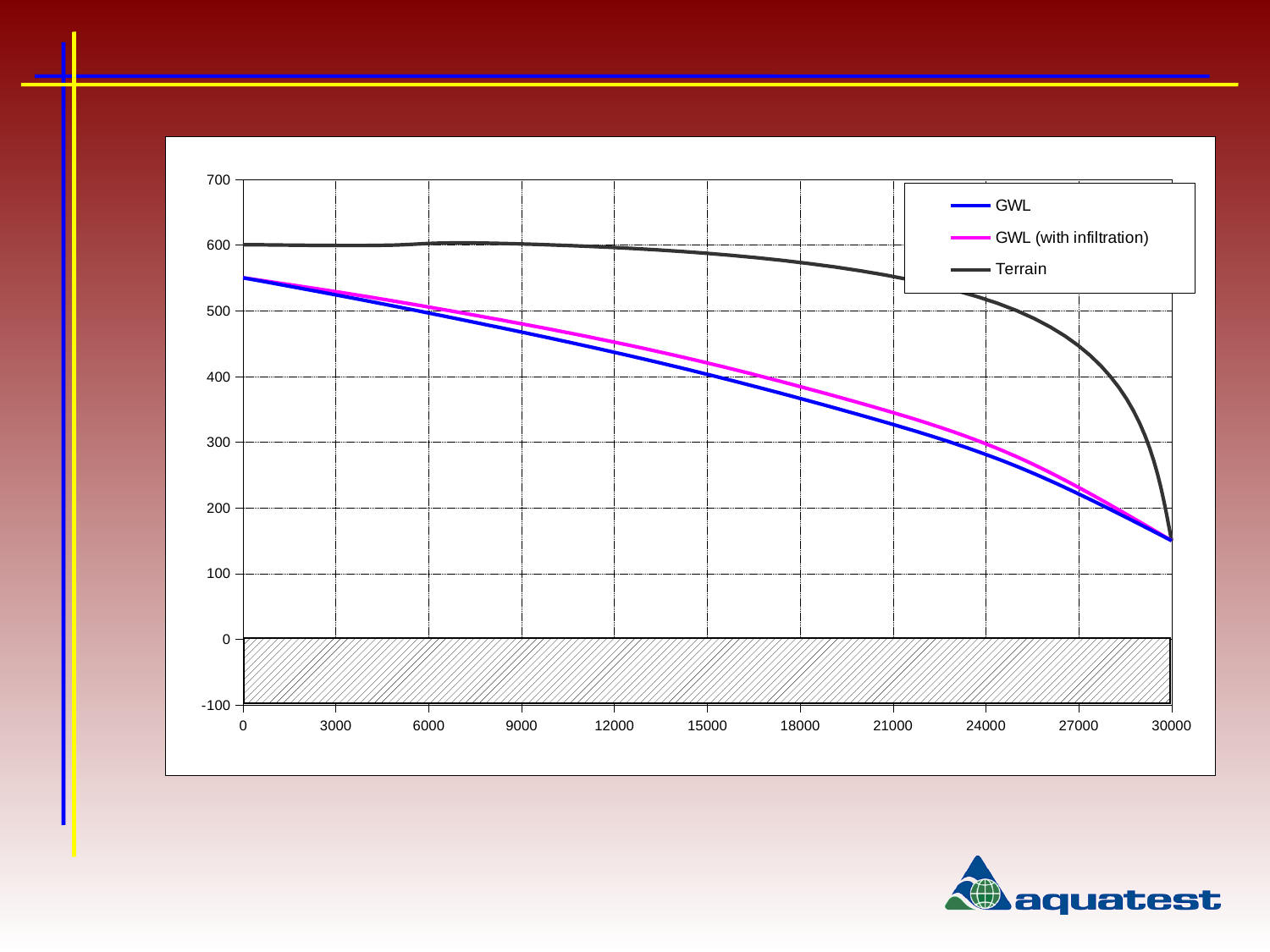
Is the value of Terrain at x = 15000 greater or less than 500? greater Is the value of GWL at x = 12000 greater or less than 400? greater Does the GWL (with infiltration) line rise or fall along the x axis? fall At x = 18000, which is larger: GWL or GWL (with infiltration)? GWL (with infiltration) Is the value of GWL at x = 30000 greater or less than 200? less Which series is drawn in black according to the legend? Terrain Does the GWL line rise or fall as the x value increases from 0 to 30000? fall What kind of chart is shown on the slide? line chart At x = 15000, which is larger: Terrain or GWL? Terrain How many series does the legend list? 3 Which series is drawn in blue according to the legend? GWL